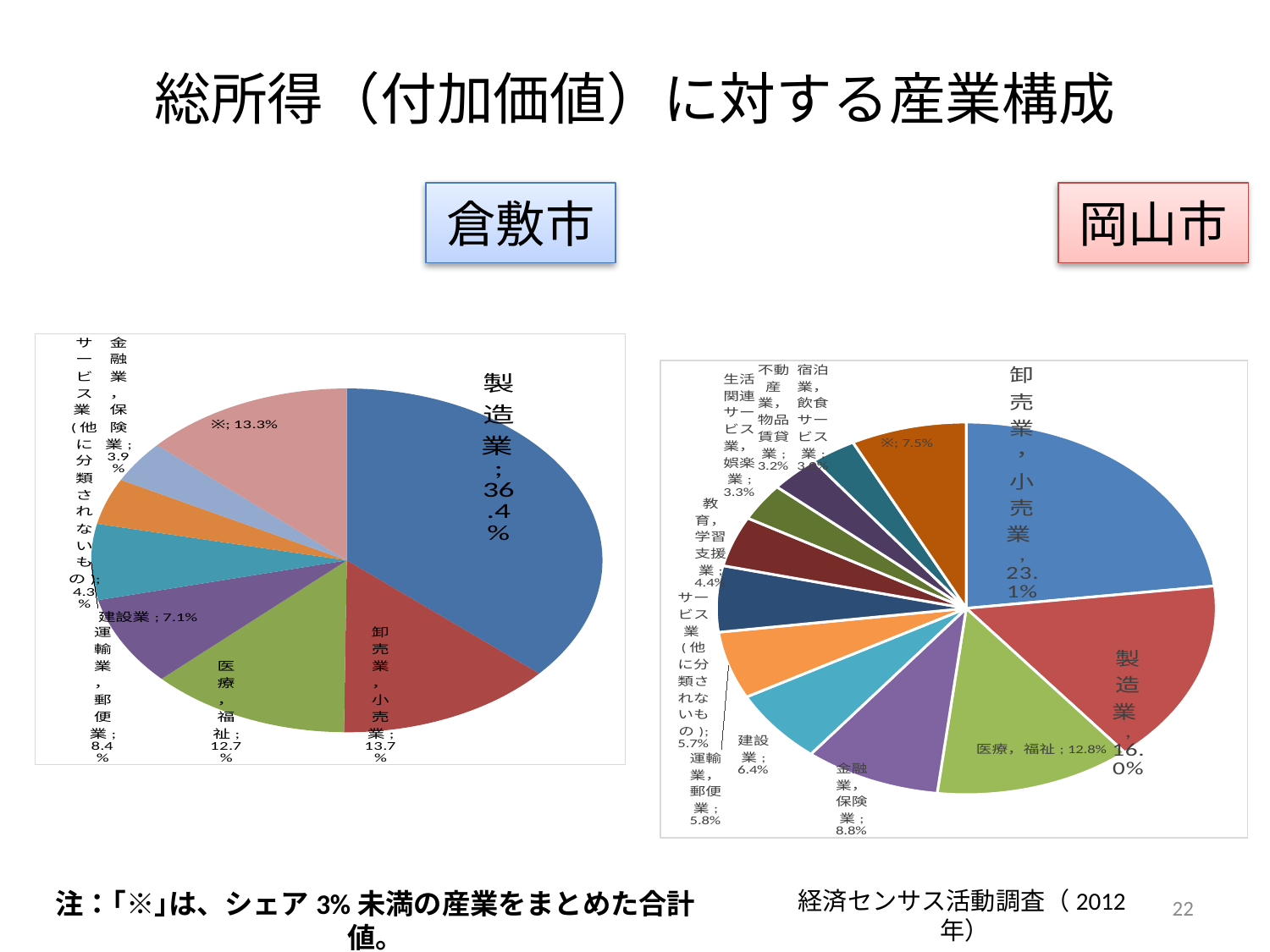
In the 倉敷市 chart, which industry has the largest share? 製造業 In the 岡山市 chart, which industry has the largest share? 卸売業，小売業 In the 岡山市 chart, what share does 金融業，保険業 have? 8.8% What is the difference between the share of 製造業 in the 倉敷市 chart and in the 岡山市 chart? 20.4% In the 岡山市 chart, what share does 卸売業，小売業 have? 23.1% In the 倉敷市 chart, what share does 卸売業，小売業 have? 13.7% Which chart shows a larger share for 医療，福祉, 倉敷市 or 岡山市? 岡山市 In the 倉敷市 chart, what share does 製造業 have? 36.4% In the 倉敷市 chart, what share does 医療，福祉 have? 12.7% What kind of charts are shown on the slide? Pie charts What is the title of the slide? 総所得（付加価値）に対する産業構成 In the 岡山市 chart, what share does 製造業 have? 16.0%